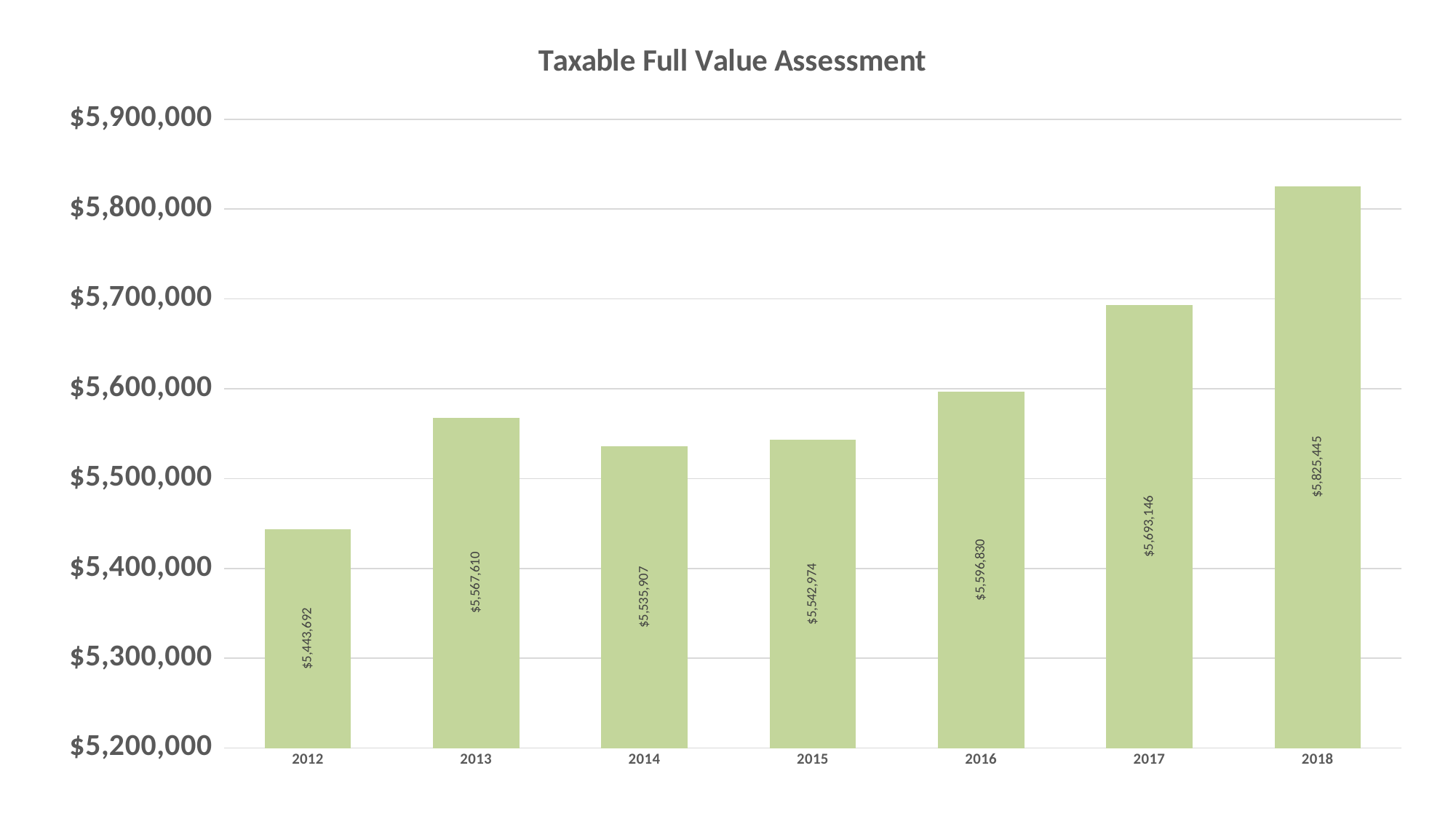
Which year has the lowest Taxable Full Value Assessment? 2012 What is the difference between the 2018 and 2017 Taxable Full Value Assessment values? $132,299 What is the title of the chart? Taxable Full Value Assessment What kind of chart is shown on the slide? Bar chart What is the Taxable Full Value Assessment for 2018? $5,825,445 What is the Taxable Full Value Assessment for 2012? $5,443,692 Does the Taxable Full Value Assessment rise or fall from 2015 to 2018? Rise Is the value for 2016 greater or less than $5,600,000? less What is the Taxable Full Value Assessment for 2015? $5,542,974 How many years are shown on the chart? 7 Which year has a larger Taxable Full Value Assessment, 2013 or 2014? 2013 Which year has the highest Taxable Full Value Assessment? 2018